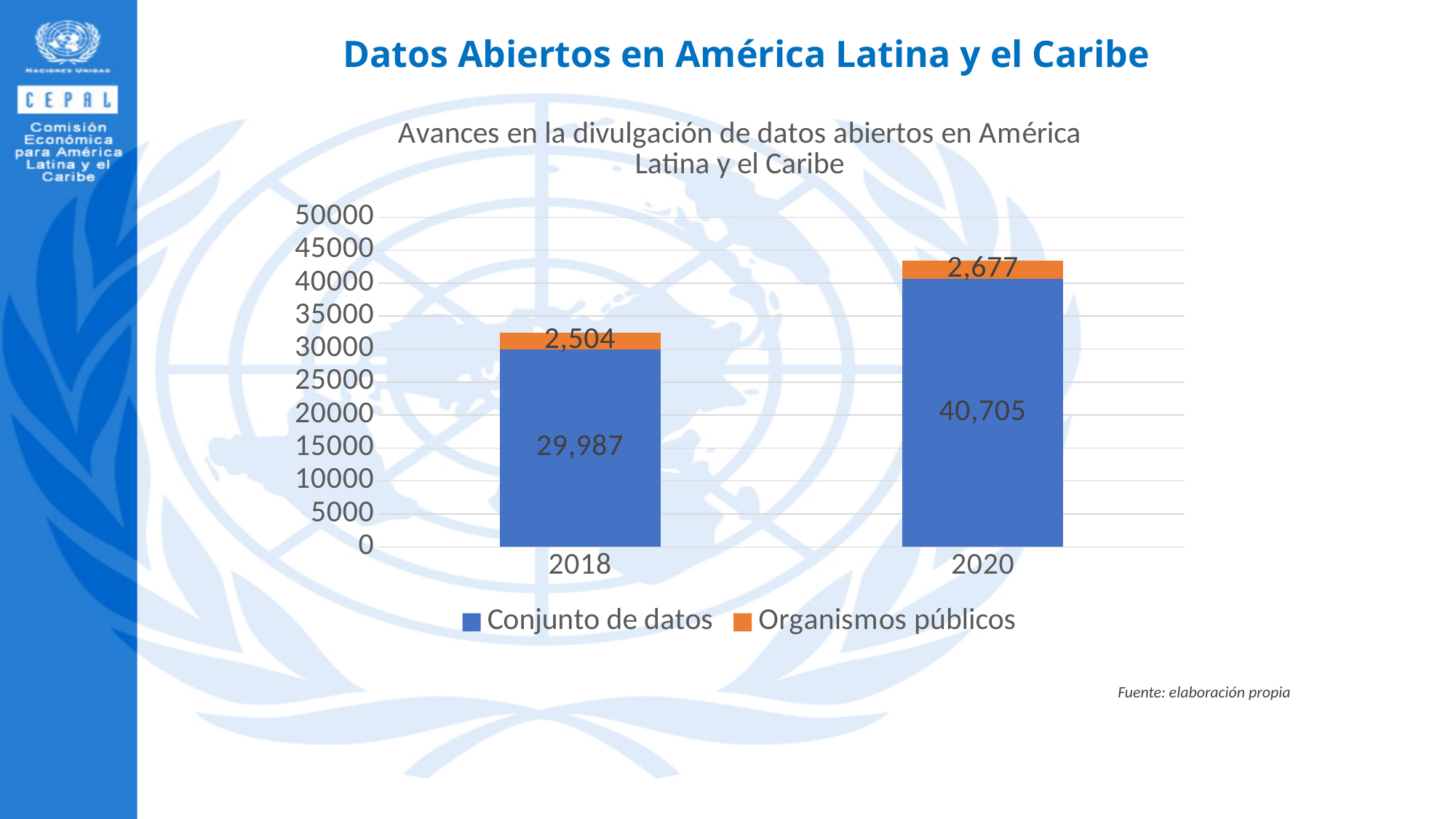
Which colour represents Organismos públicos in the chart? Orange Which year has the higher value for Conjunto de datos? 2020 What is the value of Organismos públicos for 2018? 2,504 What is the difference in Organismos públicos between 2020 and 2018? 173 What is the value of Organismos públicos for 2020? 2,677 What is the total of the stacked bar for 2020? 43,382 What is the total of the stacked bar for 2018? 32,491 What is the value of Conjunto de datos for 2020? 40,705 By how much did Conjunto de datos increase from 2018 to 2020? 10,718 What kind of chart is shown on the slide? Stacked bar chart How many series does the legend list? 2 What is the value of Conjunto de datos for 2018? 29,987